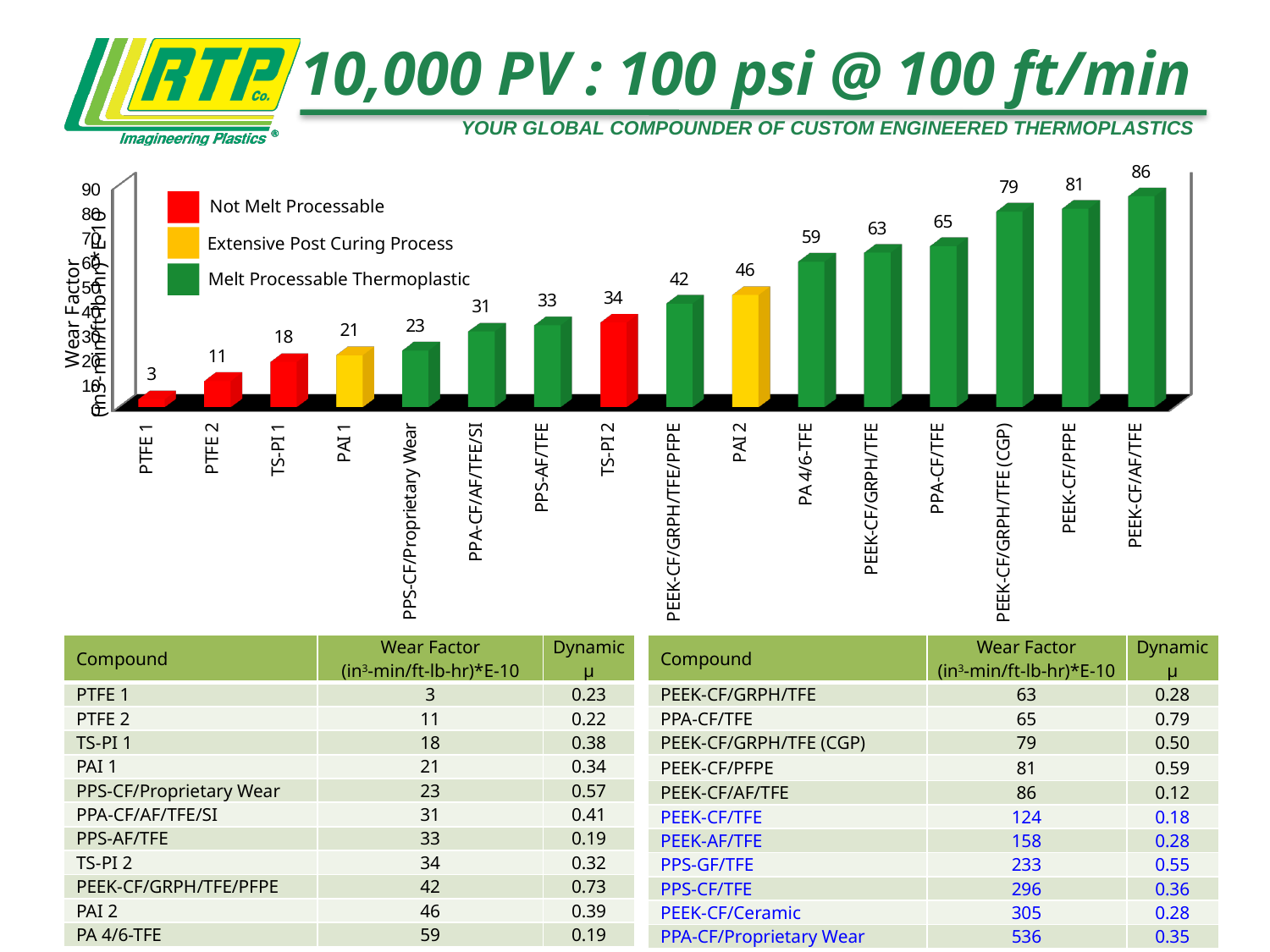
Which has a larger wear factor, TS-PI 2 or PPS-AF/TFE? TS-PI 2 Which compound has the highest wear factor in the chart? PEEK-CF/AF/TFE What is the wear factor value shown for PTFE 1? 3 How many entries does the chart legend list? 3 What is the wear factor value shown for PAI 2? 46 What is the wear factor value shown for PEEK-CF/GRPH/TFE (CGP)? 79 Which compound has the lowest wear factor in the chart? PTFE 1 Is the wear factor for PPA-CF/TFE greater or less than 60? greater Do the wear factor values rise or fall from left to right along the x axis? rise What is the difference between the wear factor of PEEK-CF/PFPE and that of PA 4/6-TFE? 22 What type of chart is shown on the slide? bar chart How many compounds (bars) are plotted in the chart? 16